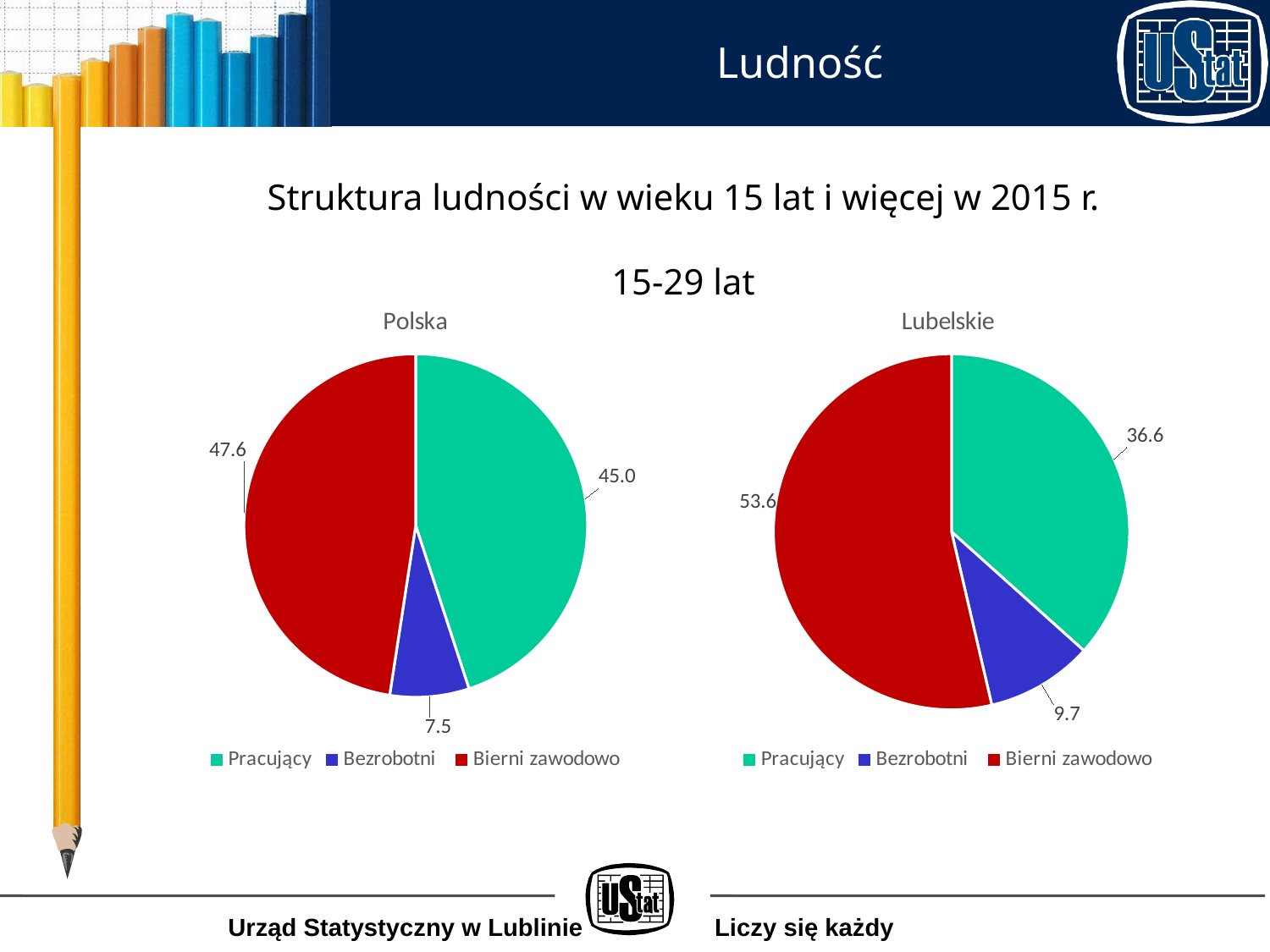
In the Polska pie chart, what is the value for Pracujący? 45.0 Which is larger: Pracujący in the Polska chart or Pracujący in the Lubelskie chart? Polska What is the difference between the Bezrobotni values in the Lubelskie and Polska pie charts? 2.2 In the Lubelskie pie chart, what is the value for Bezrobotni? 9.7 What age group do the two pie charts cover? 15-29 lat In the Polska pie chart, which category has the smallest share? Bezrobotni In the Lubelskie pie chart, which category has the largest share? Bierni zawodowo What is the difference between Bierni zawodowo and Pracujący in the Polska pie chart? 2.6 In the Lubelskie pie chart, what is the value for Bierni zawodowo? 53.6 What type of chart is used for Lubelskie? Pie chart How many categories does the Polska pie chart show? 3 What colour represents Bierni zawodowo in the Lubelskie pie chart? Red